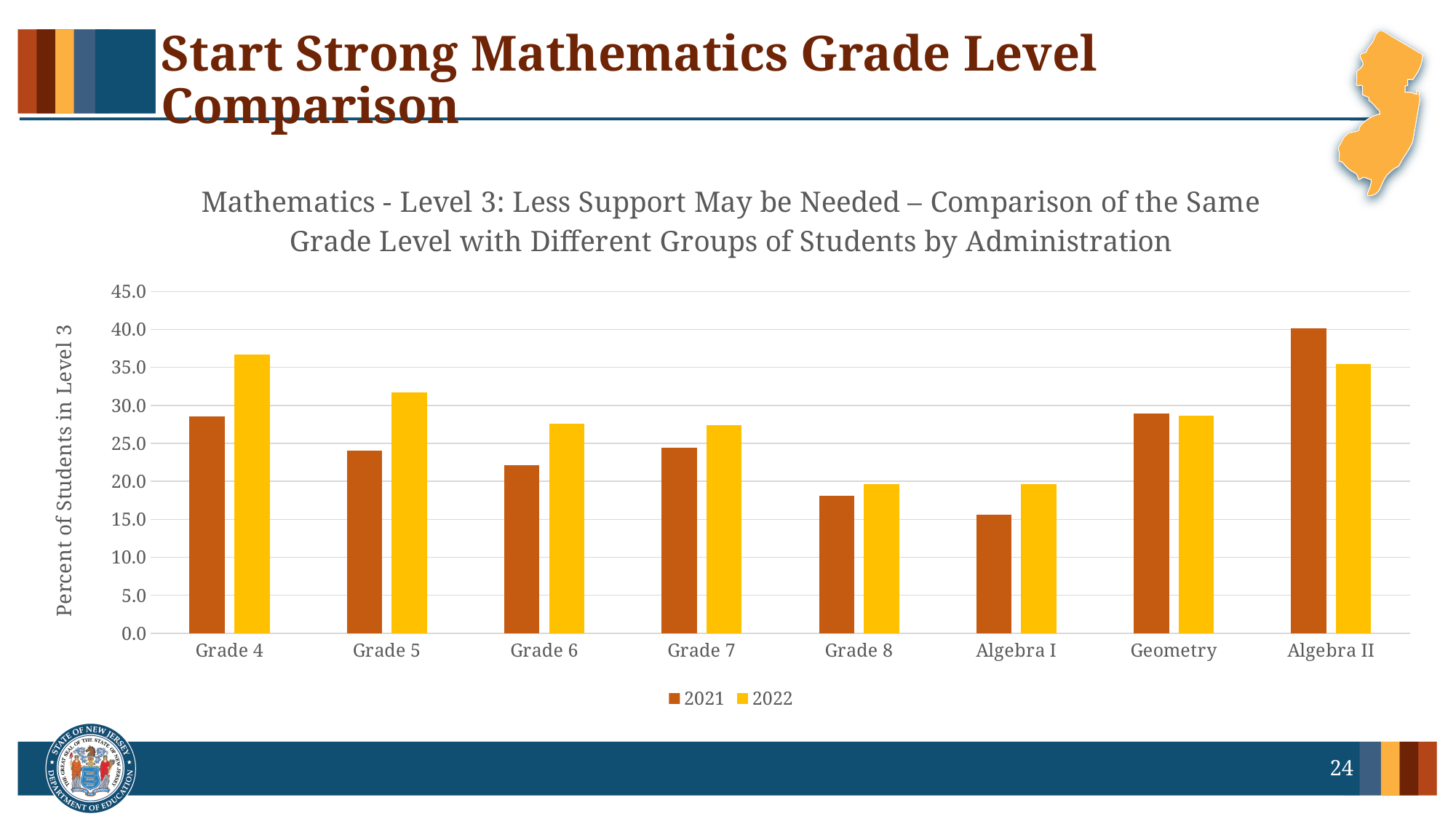
Is the 2022 value for Grade 4 greater or less than 35.0? greater How many series does the legend list? 2 Which category has the highest value for 2021? Algebra II What is the label on the vertical axis of the chart? Percent of Students in Level 3 Which category has the lowest value for 2021? Algebra I Is the 2022 value for Grade 5 greater or less than 30.0? greater Is the 2021 value for Algebra I greater or less than 20.0? less What kind of chart is shown on the slide? bar chart For Grade 4, which series has the larger value, 2021 or 2022? 2022 For Algebra II, which series has the larger value, 2021 or 2022? 2021 How many grade-level categories are shown on the x axis? 8